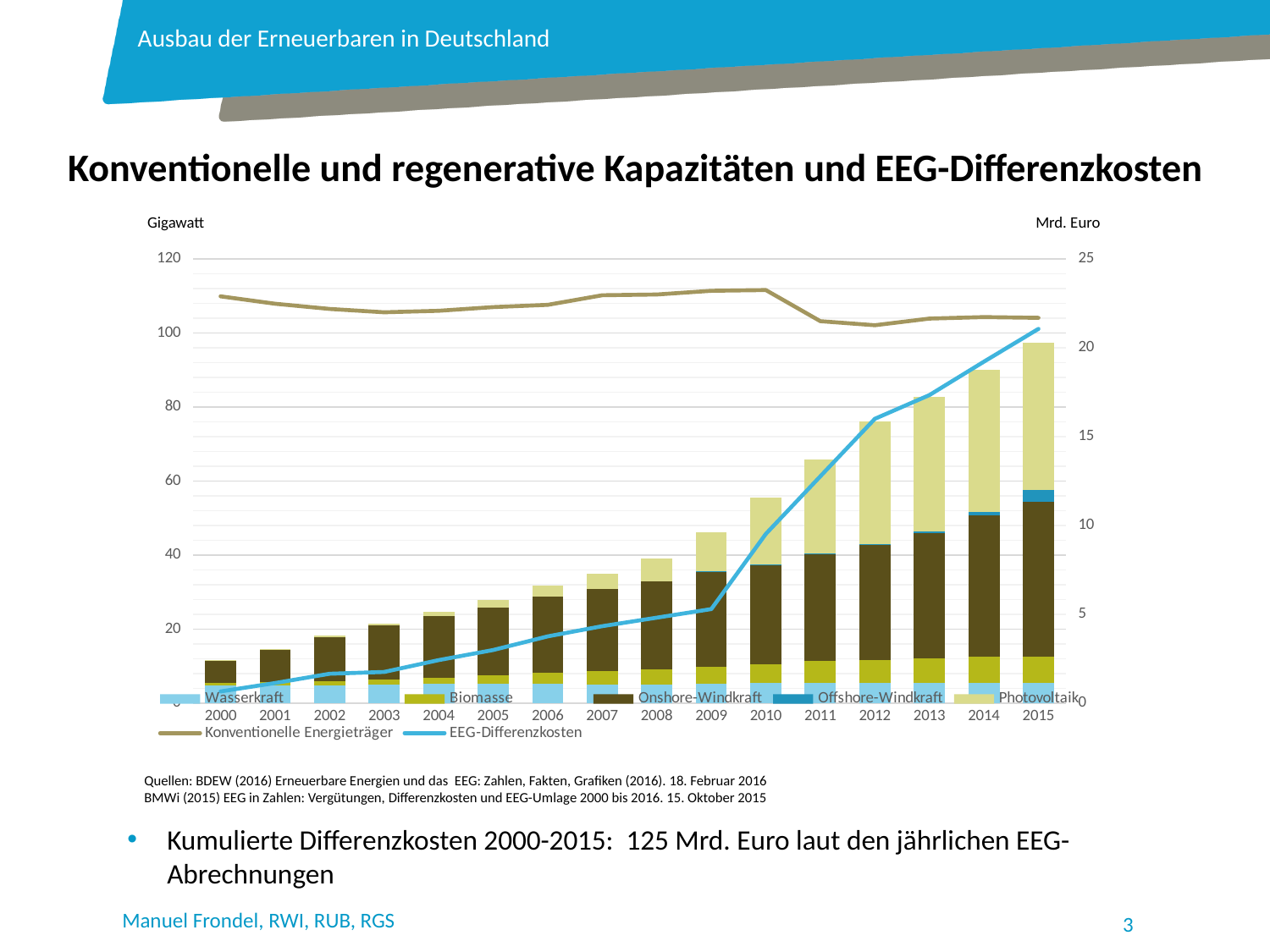
Is the EEG-Differenzkosten value for 2015 greater or less than 15 Mrd. Euro? greater Does the EEG-Differenzkosten line rise or fall from 2000 to 2015? It rises Is the total stacked bar for 2015 greater or less than 80 Gigawatt? greater Which year has the larger total stacked bar, 2010 or 2015? 2015 How many years are shown along the x axis of the chart? 16 How many series does the chart's legend list? 7 Which year has the shortest stacked bar in the chart? 2000 What kind of chart is shown on the slide? A combined stacked bar and line chart What unit is shown on the left vertical axis of the chart? Gigawatt Which year has the tallest stacked bar in the chart? 2015 Is the total stacked bar for 2000 greater or less than 20 Gigawatt? less